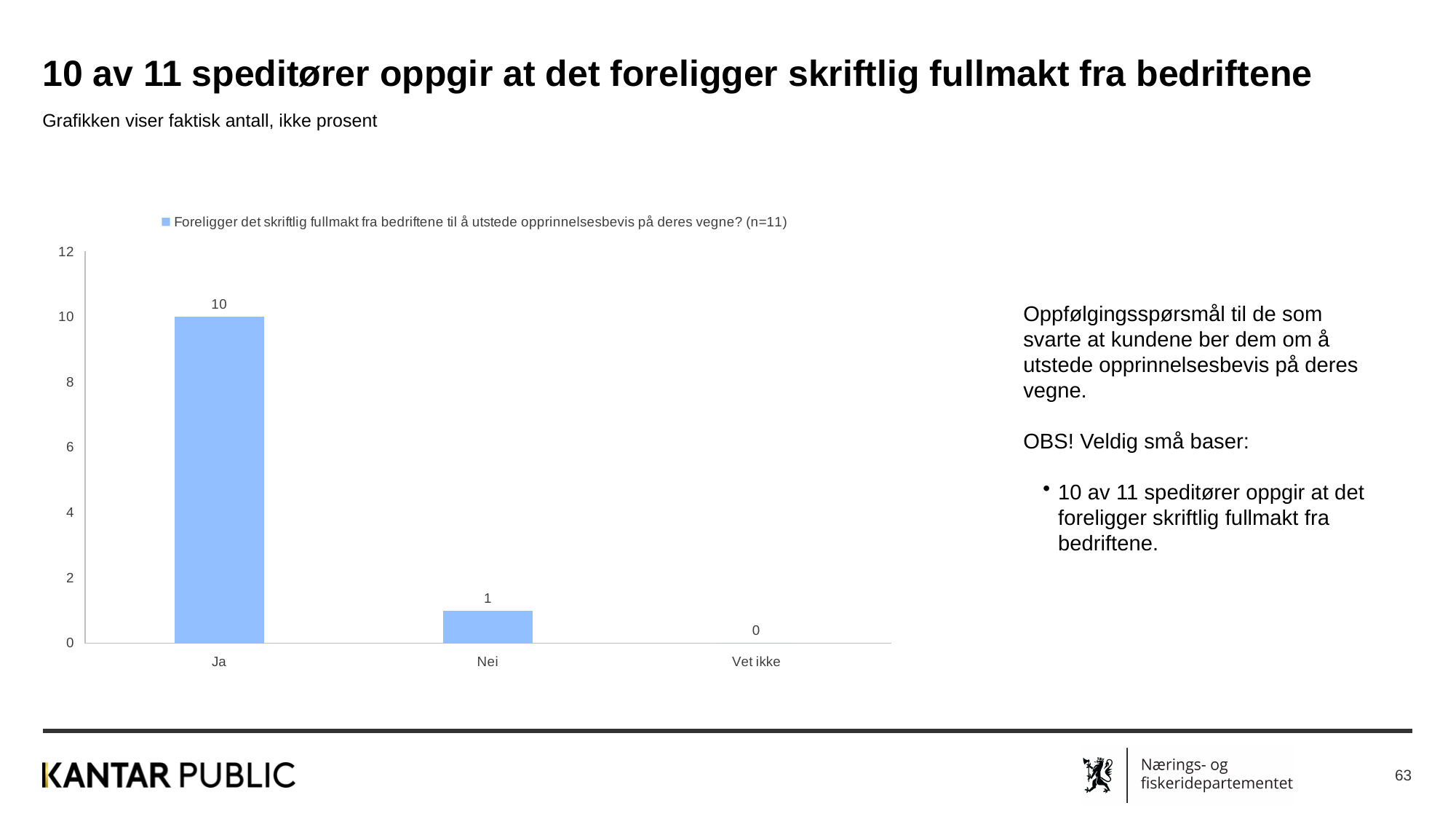
What is the value for "Ja"? 10 Which category has the highest value? Ja Is the value for "Ja" greater or less than 8? greater What is the sample size (n) given in the legend entry? n=11 What is the value for "Vet ikke"? 0 What is the value for "Nei"? 1 How many series does the legend list? 1 Which category has the lowest value? Vet ikke What is the difference between the values for "Ja" and "Nei"? 9 How many categories are shown on the x axis? 3 What kind of chart is shown on the slide? bar chart Which is larger, the value for "Nei" or the value for "Vet ikke"? Nei